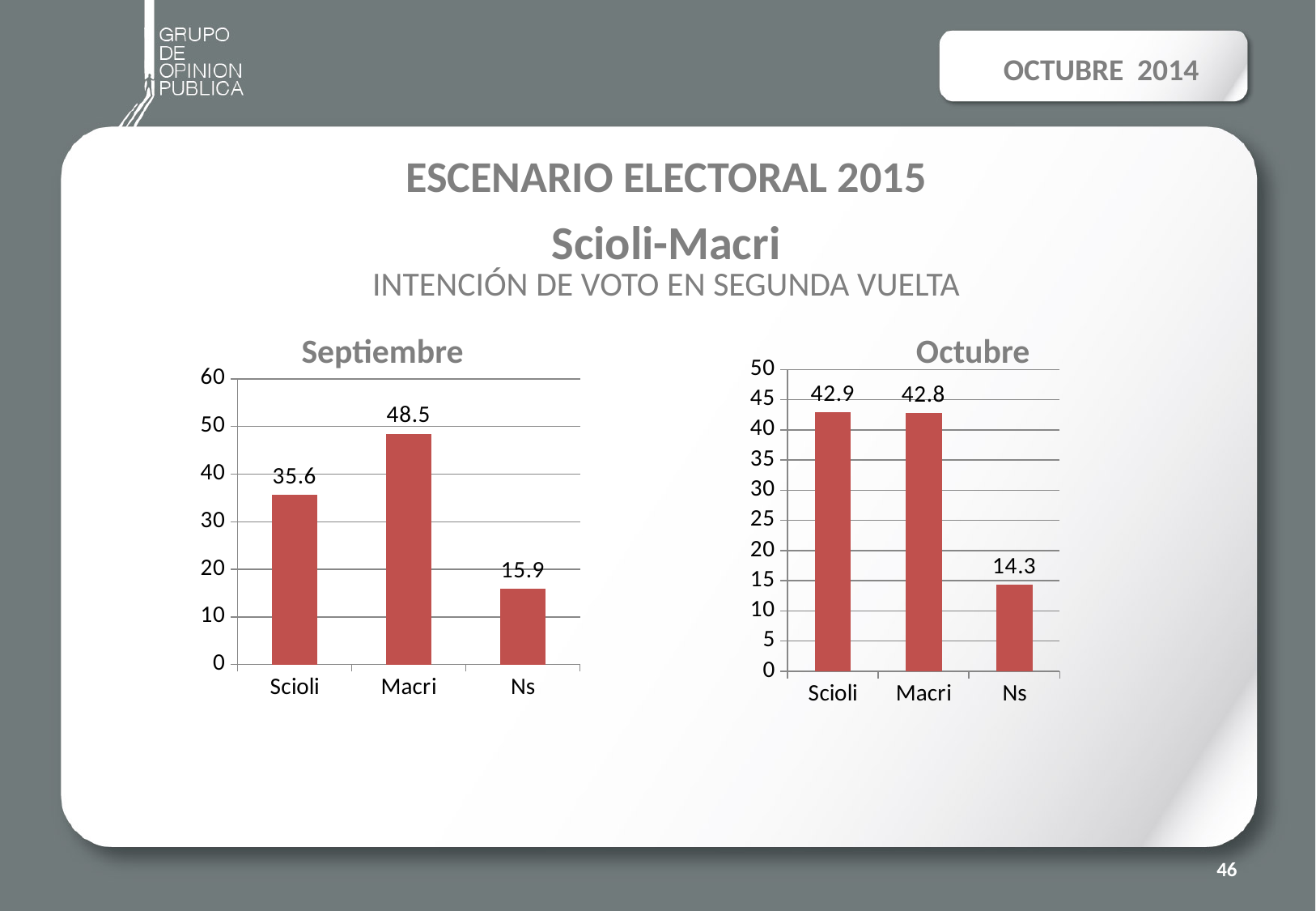
In the Septiembre chart, what is the value for Scioli? 35.6 In the Septiembre chart, which category has the highest value? Macri In the Octubre chart, what is the value for Ns? 14.3 What kind of chart is the Septiembre chart? bar chart In the Septiembre chart, what is the value for Macri? 48.5 In the Octubre chart, which category has the lowest value? Ns In the Octubre chart, what is the difference between the values for Scioli and Ns? 28.6 In the Septiembre chart, what is the difference between the values for Macri and Scioli? 12.9 In the Septiembre chart, is the value for Scioli greater or less than 30? greater How many categories are shown in the Octubre chart? 3 What is the title of the chart on the right side of the slide? Octubre In the Octubre chart, is the value for Ns greater or less than 20? less